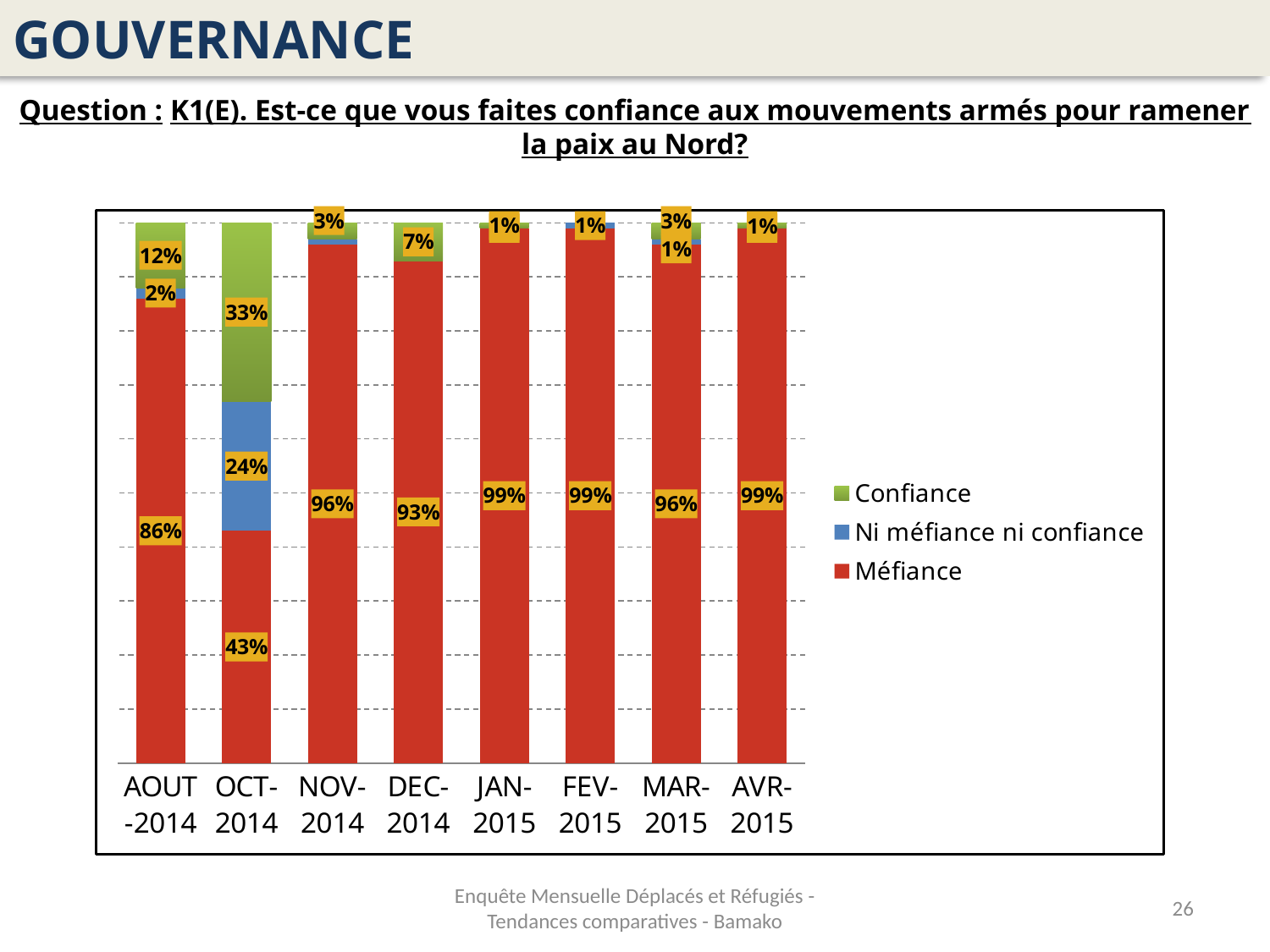
Which series is shown in red? Méfiance How many months are shown on the x axis? 8 What is the difference between the Méfiance values for AOUT-2014 and OCT-2014? 43% What is the Confiance value for OCT-2014? 33% Which is larger, the Méfiance value for NOV-2014 or for DEC-2014? NOV-2014 What is the Ni méfiance ni confiance value for OCT-2014? 24% How many series does the legend list? 3 Which month has the lowest Méfiance value? OCT-2014 What is the Méfiance value for AOUT-2014? 86% What is the Méfiance value for DEC-2014? 93% What is the Méfiance value for OCT-2014? 43% What kind of chart is shown? Stacked bar chart